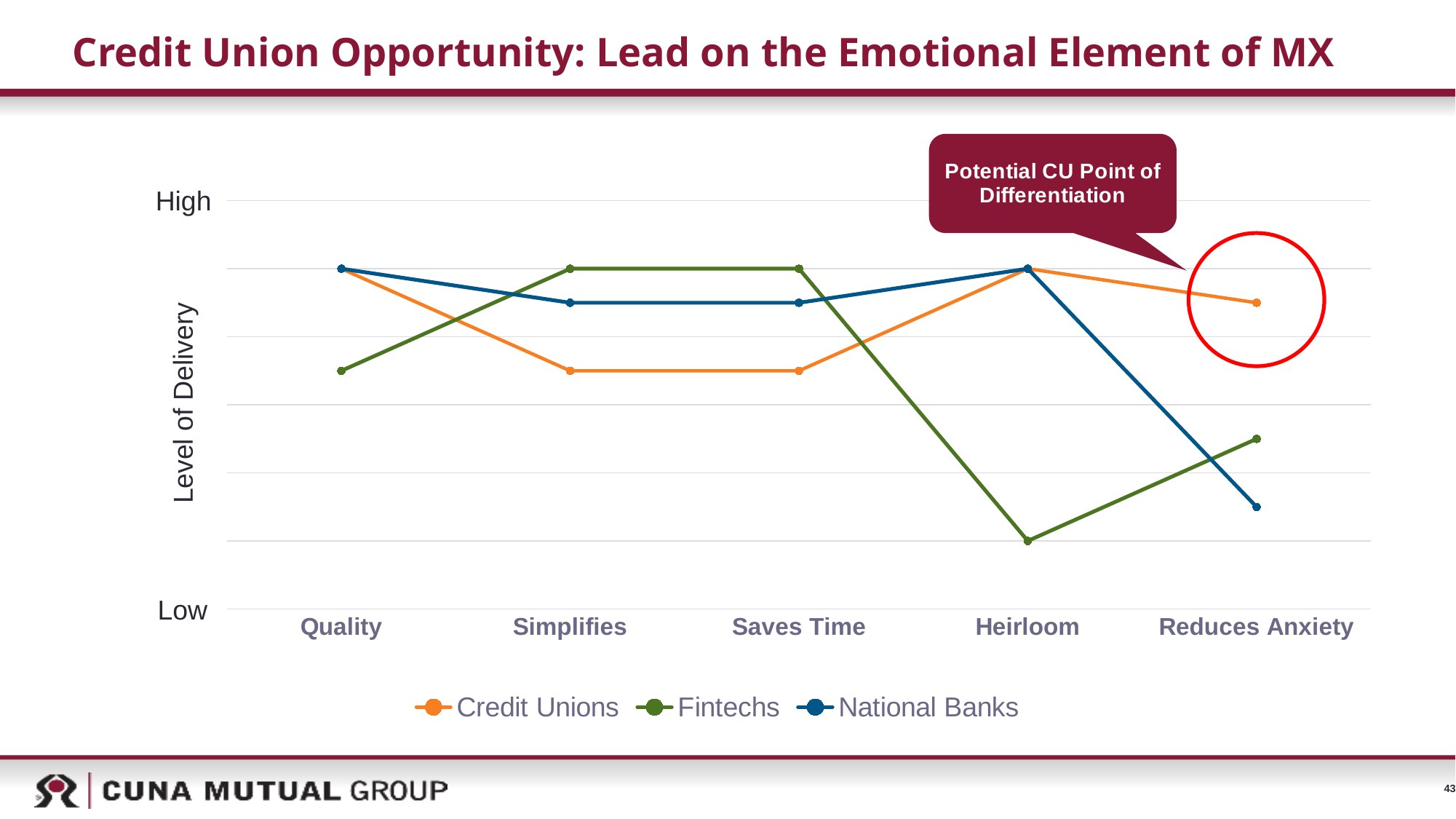
What kind of chart is shown on the slide? Line chart How many series does the chart's legend list? 3 Which series has the highest level of delivery for Simplifies? Fintechs How many categories are shown along the x axis of the chart? 5 Is the Credit Unions value for Heirloom higher or lower than its value for Saves Time? Higher Which series has the highest level of delivery for Reduces Anxiety? Credit Unions For which category is the Fintechs line at its lowest? Heirloom For which category is the National Banks line at its lowest? Reduces Anxiety What is the title of the chart's vertical axis? Level of Delivery Which series has the lowest level of delivery for Quality? Fintechs Does the National Banks line rise or fall from Heirloom to Reduces Anxiety? Fall